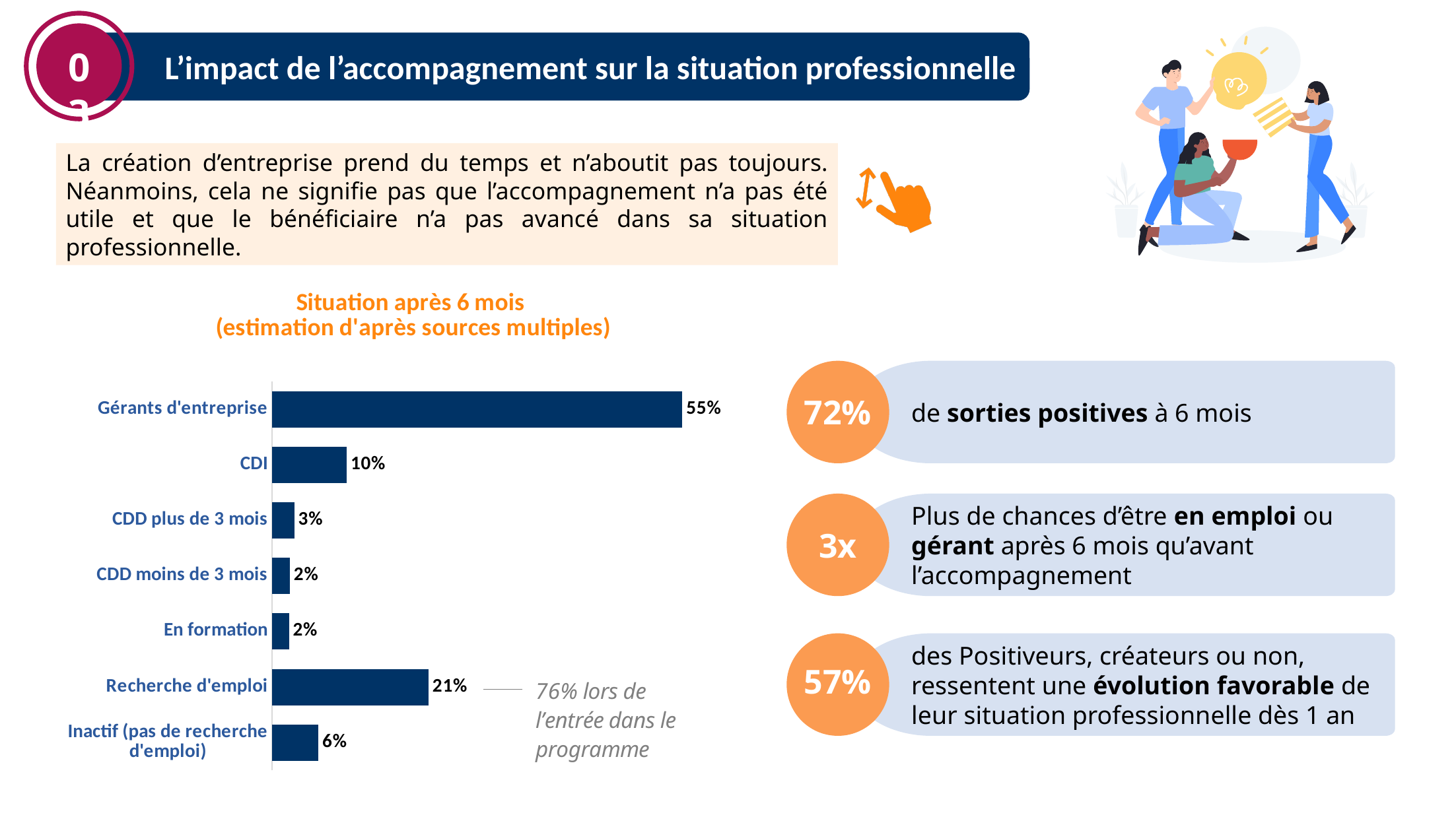
Which is larger, the value for CDI or the value for Recherche d'emploi? Recherche d'emploi What is the title of the chart? Situation après 6 mois (estimation d'après sources multiples) What is the value for Gérants d'entreprise? 55% What is the difference between the values for Gérants d'entreprise and CDI? 45% What is the difference between the values for Recherche d'emploi and Inactif (pas de recherche d'emploi)? 15% What is the value for CDI? 10% What is the value for Recherche d'emploi? 21% What kind of chart is shown on the slide? Bar chart How many categories are shown in the chart? 7 Which category has the highest value? Gérants d'entreprise What is the value for CDD plus de 3 mois? 3% What is the value for Inactif (pas de recherche d'emploi)? 6%